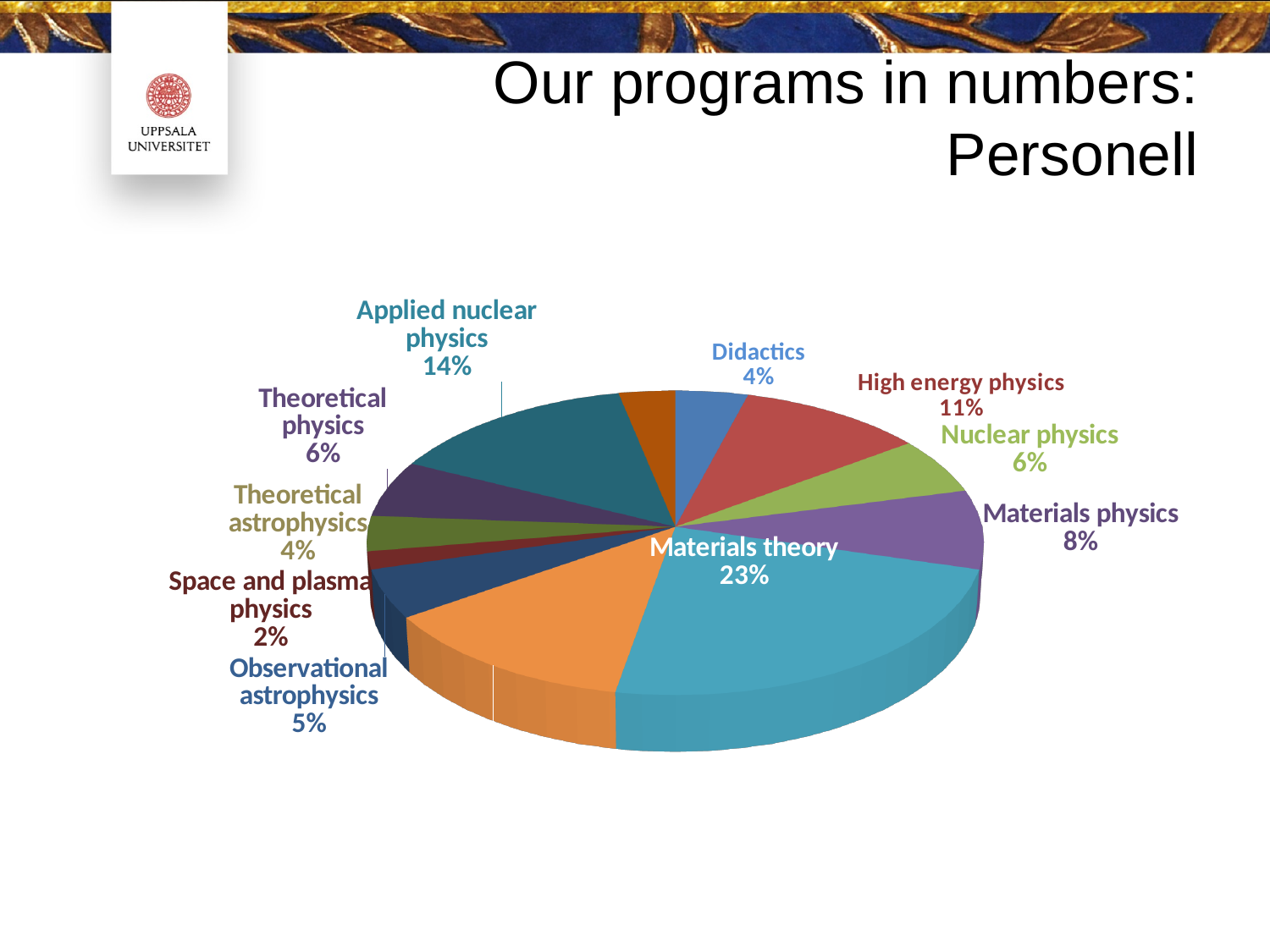
What is the title of the slide containing the pie chart? Our programs in numbers: Personell What is the difference in percentage points between Materials theory and Applied nuclear physics? 9 What is the difference in percentage points between High energy physics and Nuclear physics? 5 What percentage is shown for Space and plasma physics? 2% Which has a larger share, Didactics or Observational astrophysics? Observational astrophysics Which labelled program has the largest share of the pie? Materials theory What percentage is shown for Observational astrophysics? 5% What share of personnel is in Materials theory? 23% What percentage is shown for Applied nuclear physics? 14% Which has a larger share, Materials physics or Theoretical physics? Materials physics What percentage is shown for High energy physics? 11% What type of chart is shown on the slide? pie chart